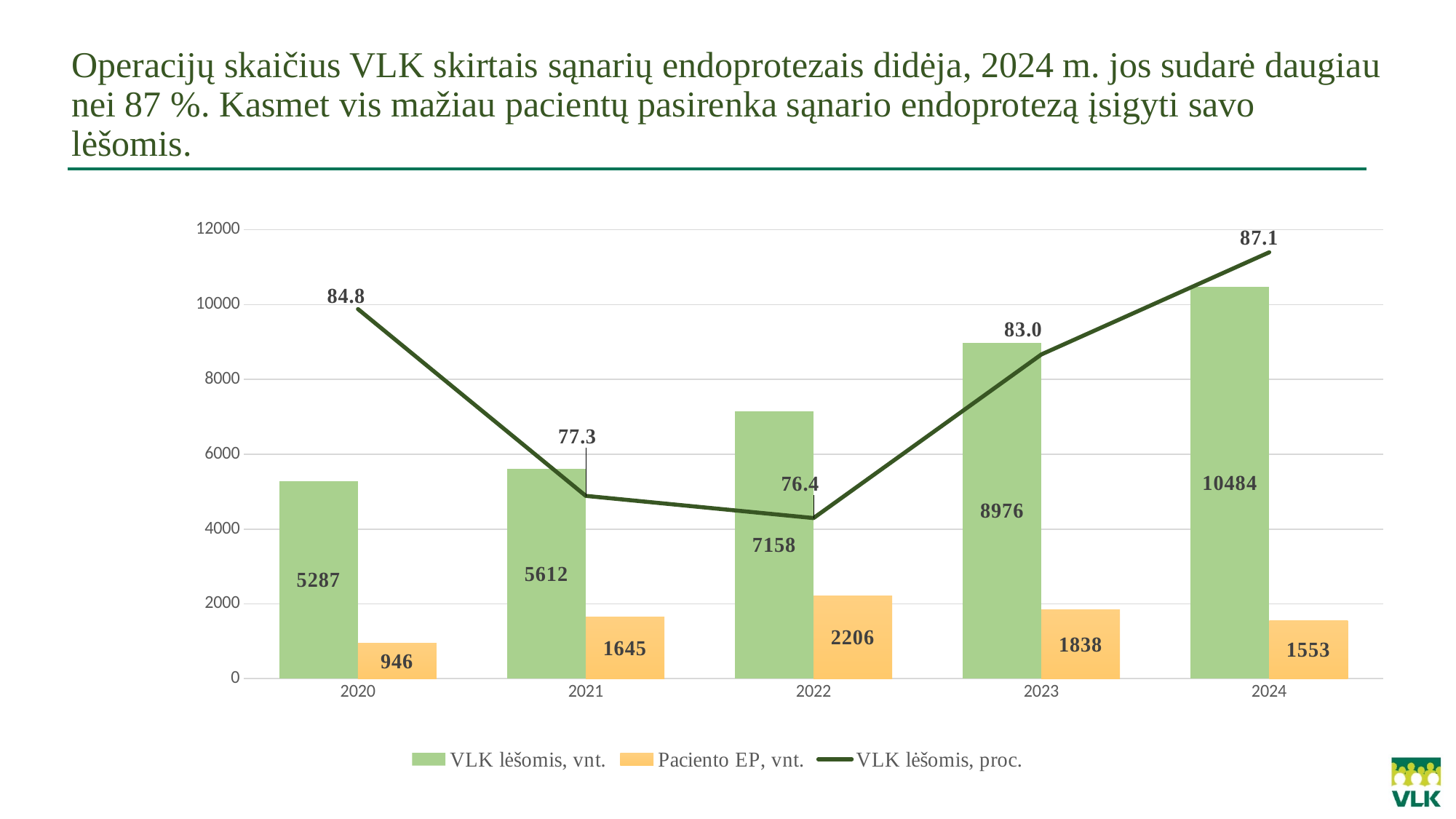
What is the value of 'VLK lėšomis, vnt.' for 2024? 10484 How many series does the legend list? 3 Which is larger: 'Paciento EP, vnt.' for 2021 or for 2024? 2021 Which year has the lowest value for 'VLK lėšomis, proc.'? 2022 What is the value of 'VLK lėšomis, proc.' for 2021? 77.3 Is the value of 'VLK lėšomis, vnt.' for 2022 greater or less than 6000? greater How many years are shown on the x axis? 5 What is the difference between the 'VLK lėšomis, vnt.' values for 2024 and 2023? 1508 Which year has the lowest value for 'Paciento EP, vnt.'? 2020 Does the 'VLK lėšomis, vnt.' series rise or fall from 2020 to 2024? rise Which year has the highest value for 'VLK lėšomis, vnt.'? 2024 What is the value of 'Paciento EP, vnt.' for 2022? 2206